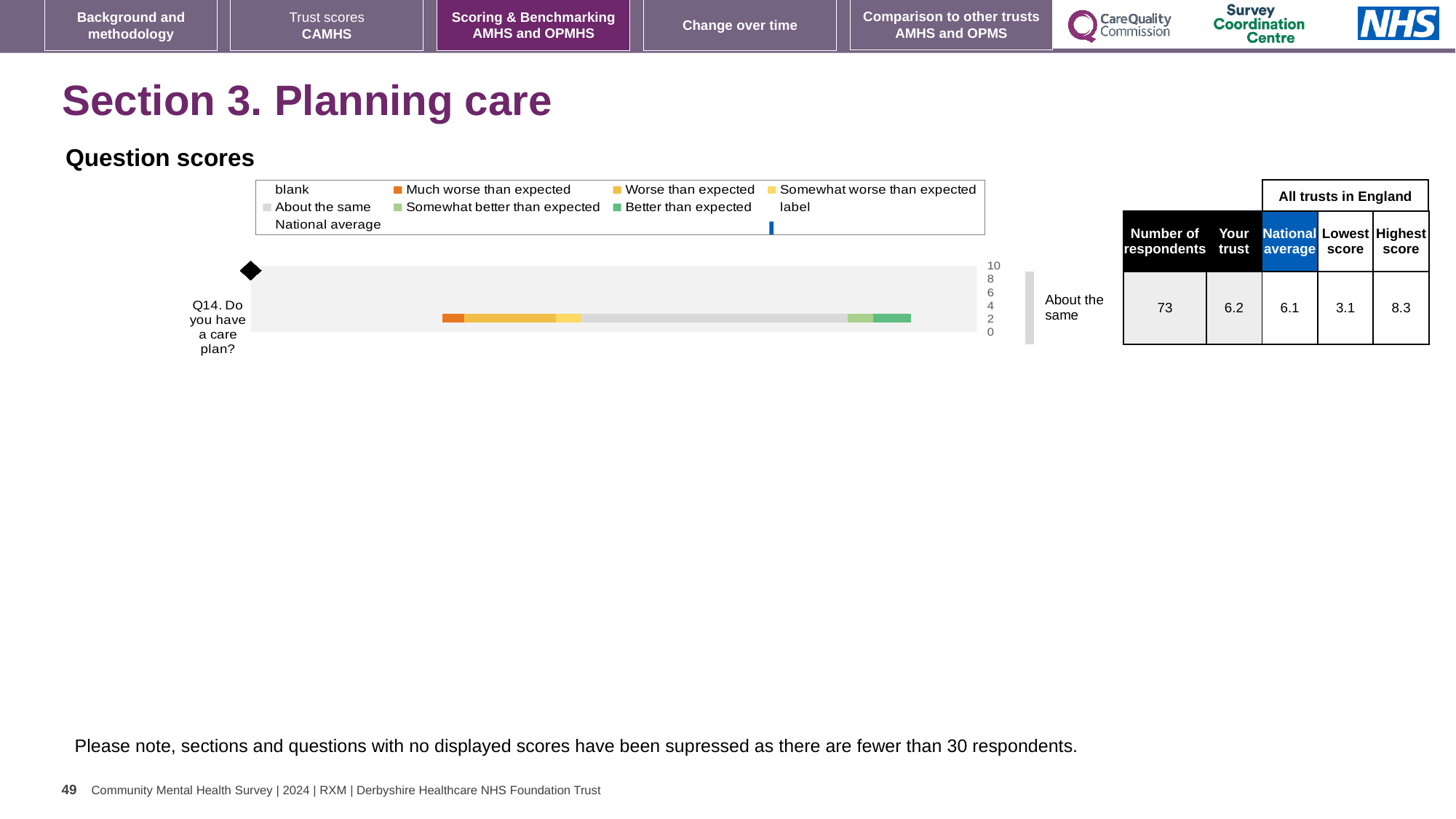
What kind of chart is shown for Q14 on the slide? bar chart What benchmark category is shown next to the Q14 bar? About the same What is the 'Your trust' score for Q14 shown beside the chart? 6.2 What is the maximum value shown on the chart's score axis? 10 Which is larger for Q14, the trust score or the national average? the trust score What is the lowest score among all trusts in England for Q14? 3.1 How many respondents answered Q14? 73 Which question is plotted in the Question scores chart? Q14. Do you have a care plan? What is the highest score among all trusts in England for Q14? 8.3 What is the national average score for Q14 shown beside the chart? 6.1 How many questions are plotted in the Question scores chart? 1 What is the difference between the highest and lowest scores for Q14 across all trusts in England? 5.2